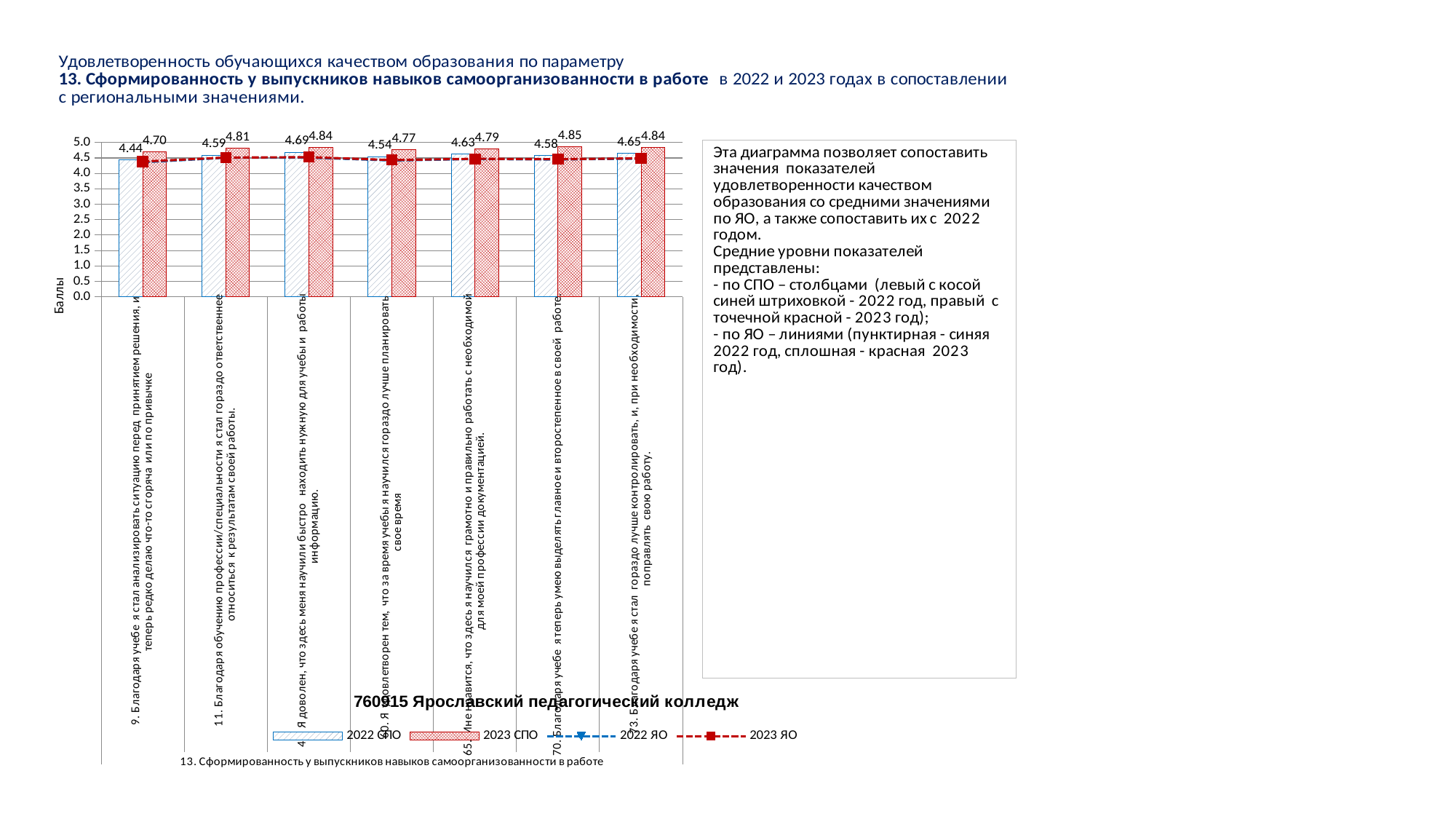
What is the 2023 СПО value for category 70 ("Благодаря учебе я теперь умею выделять главное и второстепенное в своей работе")? 4.85 What is the 2023 СПО value for category 11 ("Благодаря обучению профессии/специальности я стал гораздо ответственнее относиться к результатам своей работы")? 4.81 What is the 2022 СПО value for category 9 ("Благодаря учебе я стал анализировать ситуацию перед принятием решения...")? 4.44 What is the difference between the 2023 СПО and 2022 СПО values for category 9? 0.26 Which category has the lowest 2022 СПО value? 9. Благодаря учебе я стал анализировать ситуацию перед принятием решения (4.44) How many categories are shown on the x axis of the chart? 7 What is the label of the vertical axis of the chart? Баллы Which category has the highest 2023 СПО value? 70. Благодаря учебе я теперь умею выделять главное и второстепенное в своей работе (4.85) For category 65 ("Мне нравится, что здесь я научился грамотно и правильно работать с необходимой для моей профессии документацией"), which is larger: the 2022 СПО value or the 2023 СПО value? 2023 СПО (4.79) What kind of chart is shown on the slide? Combined bar and line chart How many series does the chart legend list? 4